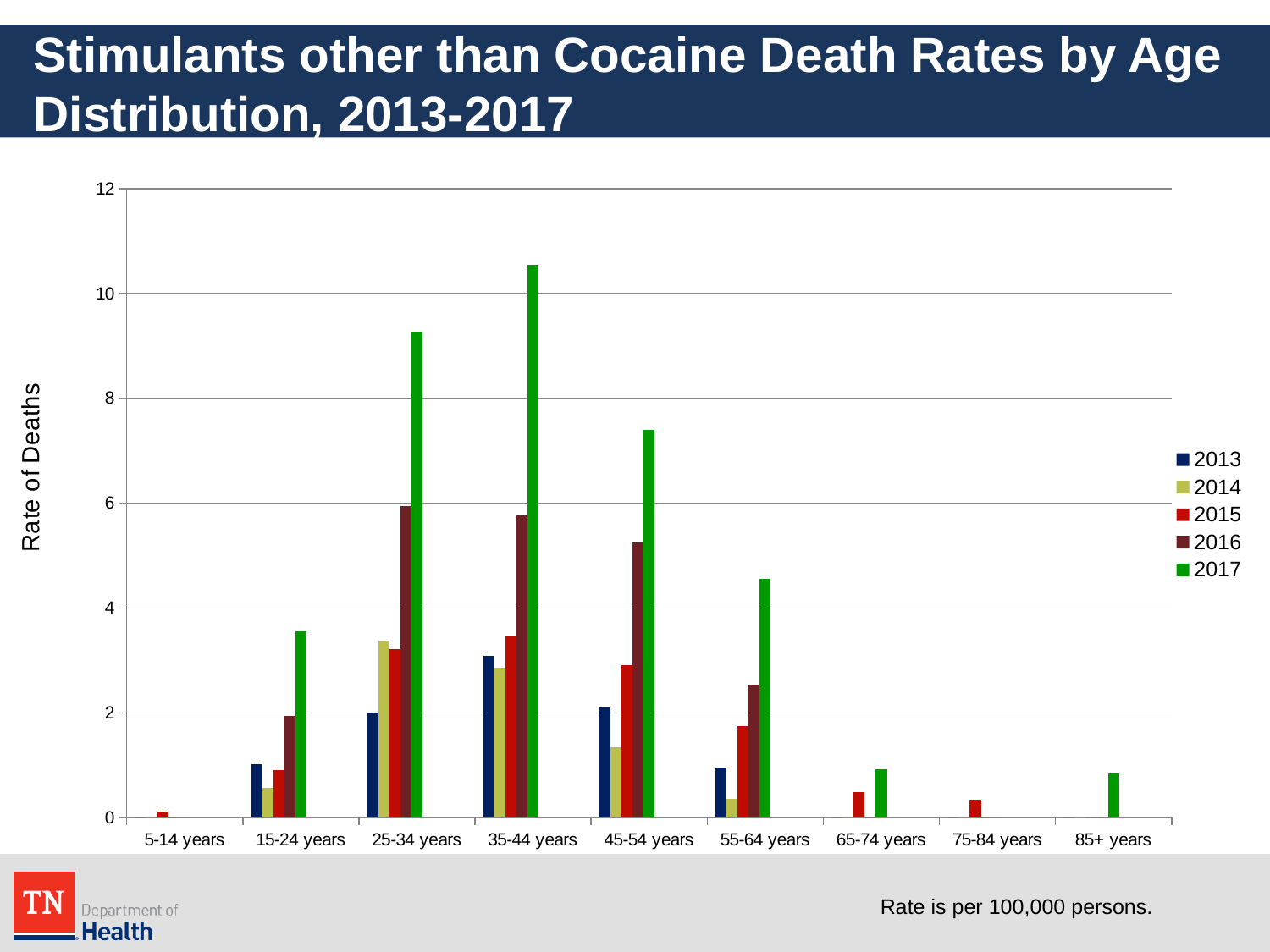
What is the title of the y axis? Rate of Deaths For 35-44 years, do the values rise or fall from 2015 to 2017? rise What kind of chart is shown on the slide? bar chart How many age groups are shown on the x axis? 9 For 45-54 years, which year has the larger value, 2015 or 2016? 2016 Is the 2017 value for 25-34 years greater or less than 8? greater How many series does the legend list? 5 Is the 2013 value for 35-44 years greater or less than 2? greater Which age group has the highest 2017 death rate? 35-44 years Which is larger, the 2017 value for 25-34 years or the 2017 value for 45-54 years? 25-34 years Is the 2017 value for 35-44 years greater or less than 10? greater